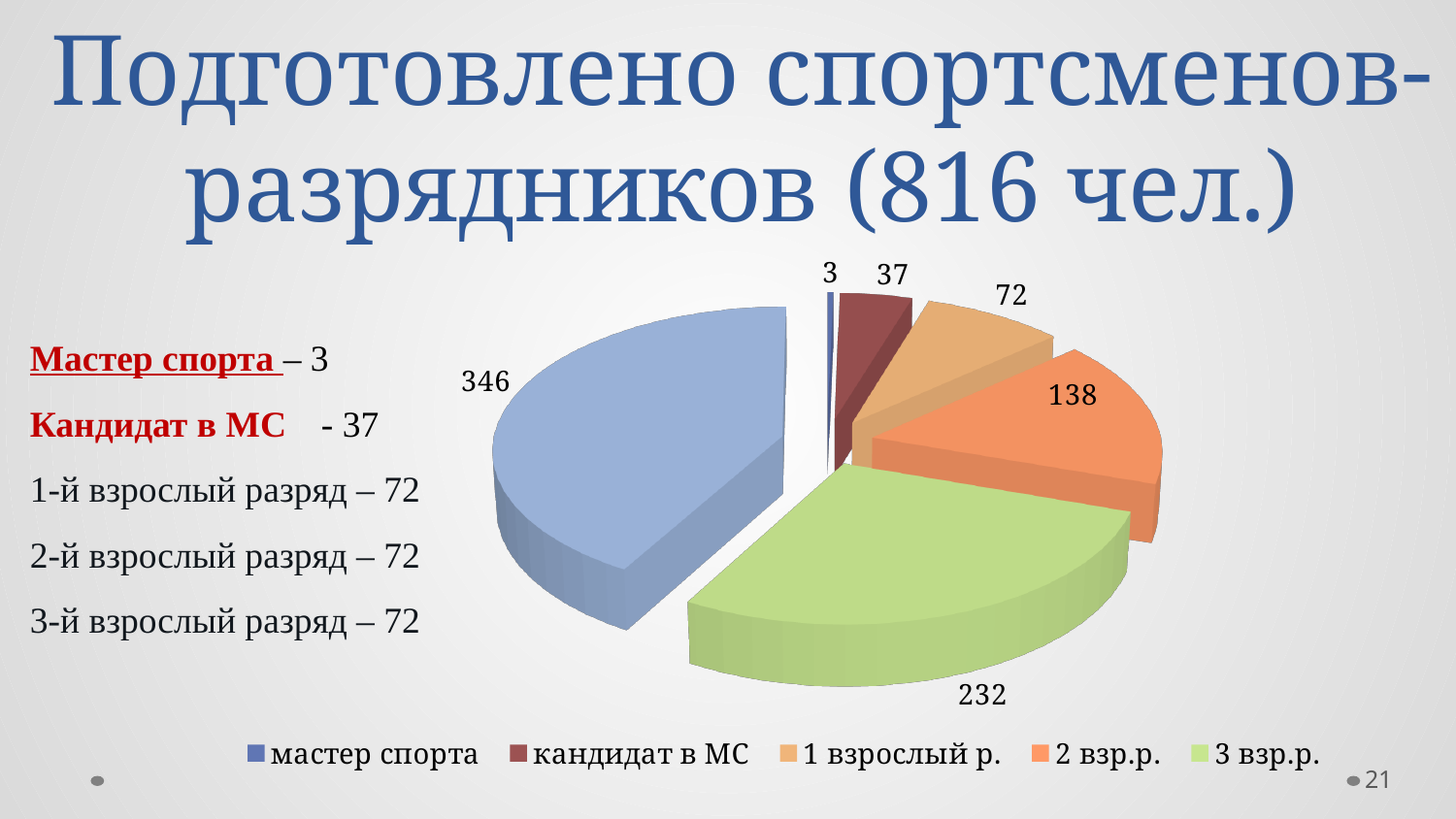
What is the value for 1 взрослый р. in the pie chart? 72 What type of chart is shown on the slide? pie chart What is the value for 2 взр.р. in the pie chart? 138 What is the value for кандидат в МС in the pie chart? 37 What is the value for 3 взр.р. in the pie chart? 232 How many slices does the pie chart have? 6 What is the difference between the values for 3 взр.р. and 2 взр.р.? 94 Which is larger, the value for 2 взр.р. or the value for 1 взрослый р.? 2 взр.р. What colour is the 3 взр.р. slice in the pie chart? green What is the largest value labelled on the pie chart? 346 How many entries does the legend list? 5 What is the smallest value labelled on the pie chart? 3